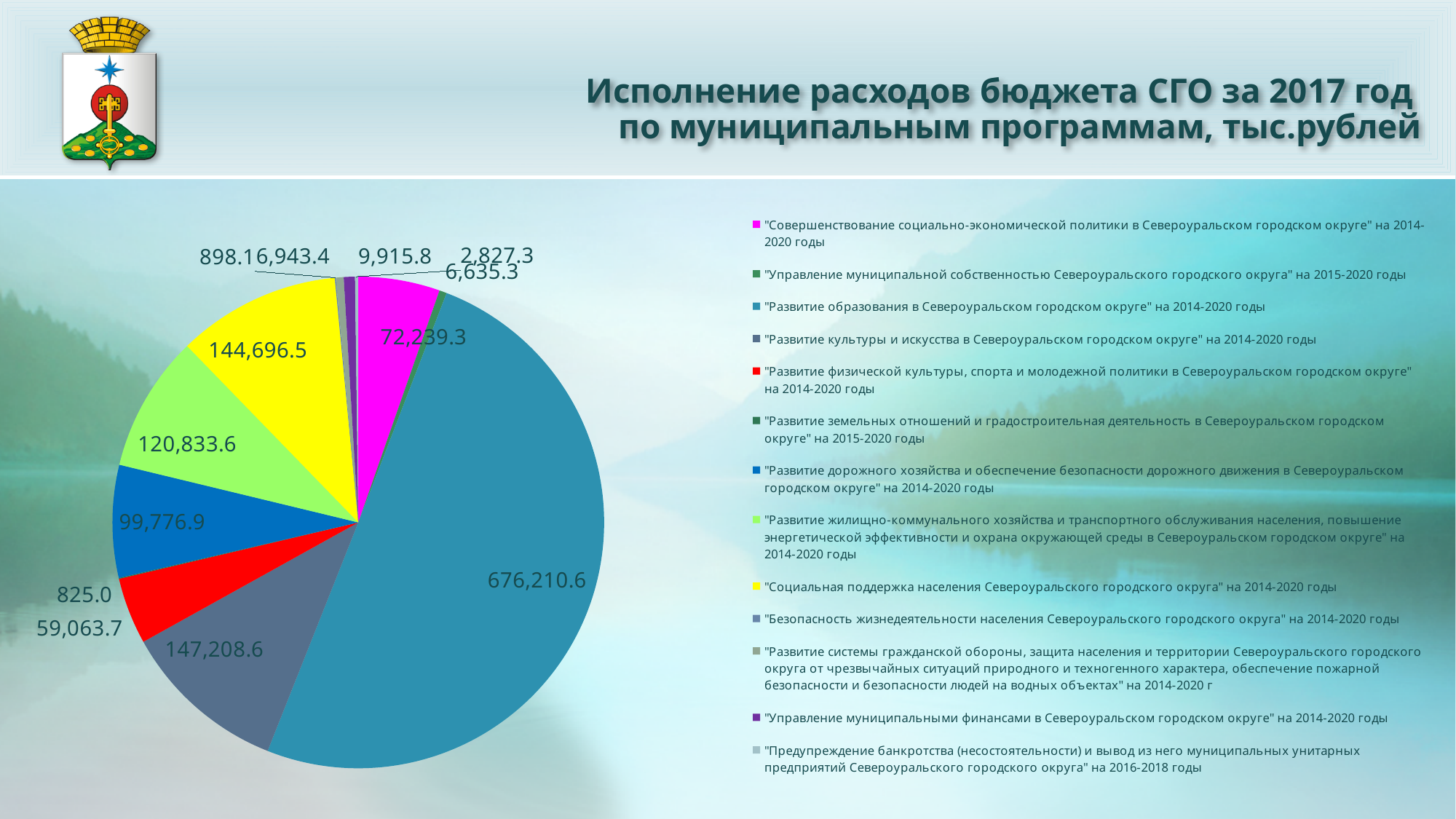
Which programme has the largest slice of the pie? "Развитие образования в Североуральском городском округе" на 2014-2020 годы What type of chart is shown on the slide? pie chart What is the value for the programme "Развитие образования в Североуральском городском округе" на 2014-2020 годы? 676,210.6 What is the title of the slide containing the pie chart? Исполнение расходов бюджета СГО за 2017 год по муниципальным программам, тыс.рублей What is the value for the programme "Развитие дорожного хозяйства и обеспечение безопасности дорожного движения в Североуральском городском округе" на 2014-2020 годы? 99,776.9 What is the value for the programme "Развитие культуры и искусства в Североуральском городском округе" на 2014-2020 годы? 147,208.6 How many programmes (slices) are listed in the legend of the pie chart? 13 What is the difference between the value for "Развитие культуры и искусства" (147,208.6) and the value for "Социальная поддержка населения" (144,696.5)? 2,512.1 Which programme has the smallest value in the pie chart? "Развитие земельных отношений и градостроительная деятельность в Североуральском городском округе" на 2015-2020 годы Which is larger: the value for "Развитие жилищно-коммунального хозяйства..." or the value for "Развитие дорожного хозяйства..."? "Развитие жилищно-коммунального хозяйства..." (120,833.6) What is the value for the programme "Развитие физической культуры, спорта и молодежной политики в Североуральском городском округе" на 2014-2020 годы? 59,063.7 What is the value for the programme "Социальная поддержка населения Североуральского городского округа" на 2014-2020 годы? 144,696.5